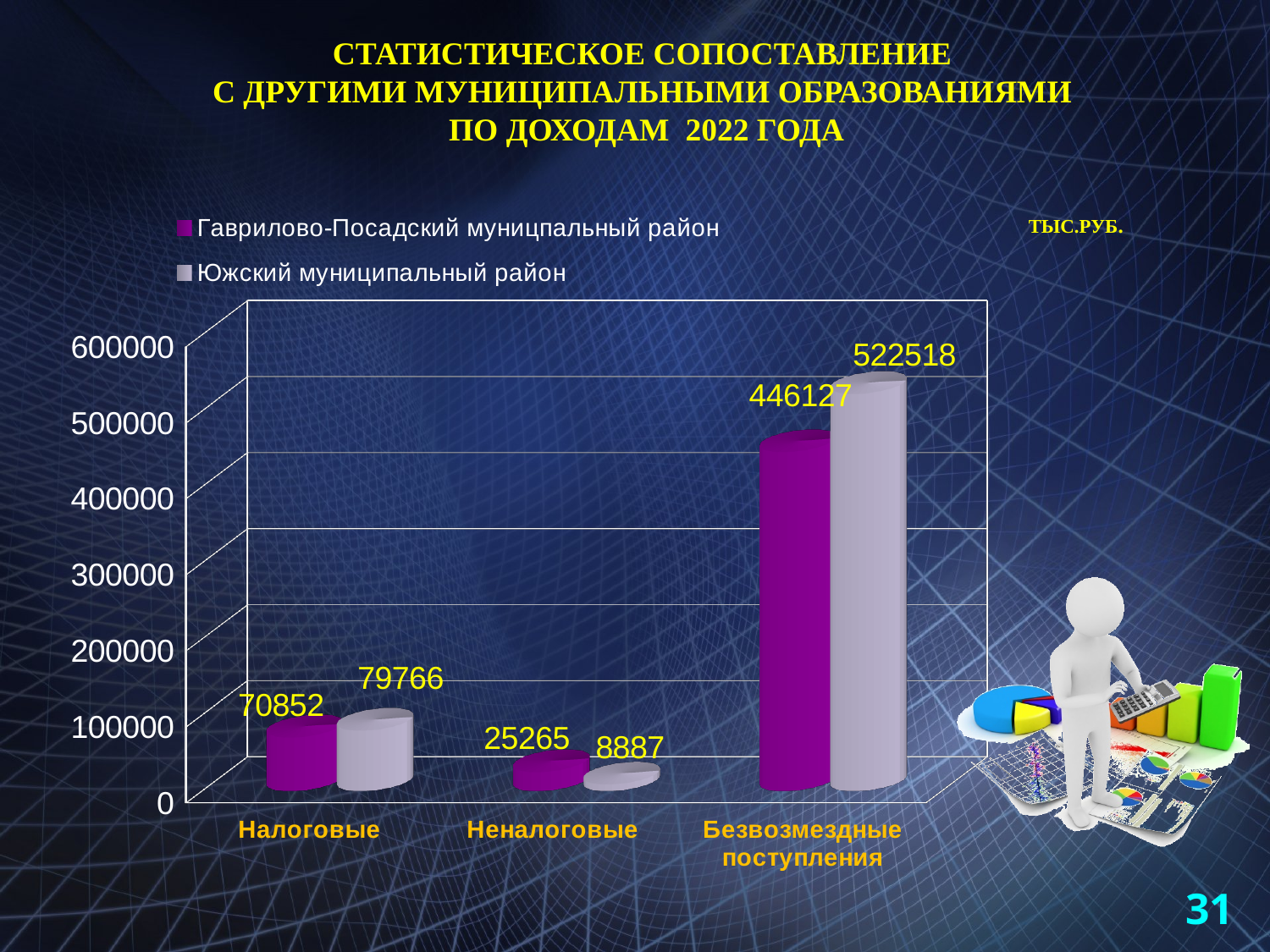
How many categories are shown on the x axis? 3 What unit is indicated for the values on the chart? ТЫС.РУБ. What is the value for Южский муниципальный район in the Безвозмездные поступления category? 522518 What is the value for Гаврилово-Посадский муниципальный район in the Неналоговые category? 25265 Which category has the lowest value for Южский муниципальный район? Неналоговые What is the value for Южский муниципальный район in the Налоговые category? 79766 In the Неналоговые category, which district has the larger value? Гаврилово-Посадский муниципальный район How many series does the legend list? 2 What is the value for Гаврилово-Посадский муниципальный район in the Налоговые category? 70852 What kind of chart is shown on the slide? Bar chart What is the difference between the two districts' values in the Безвозмездные поступления category? 76391 Which category has the highest value for Гаврилово-Посадский муниципальный район? Безвозмездные поступления